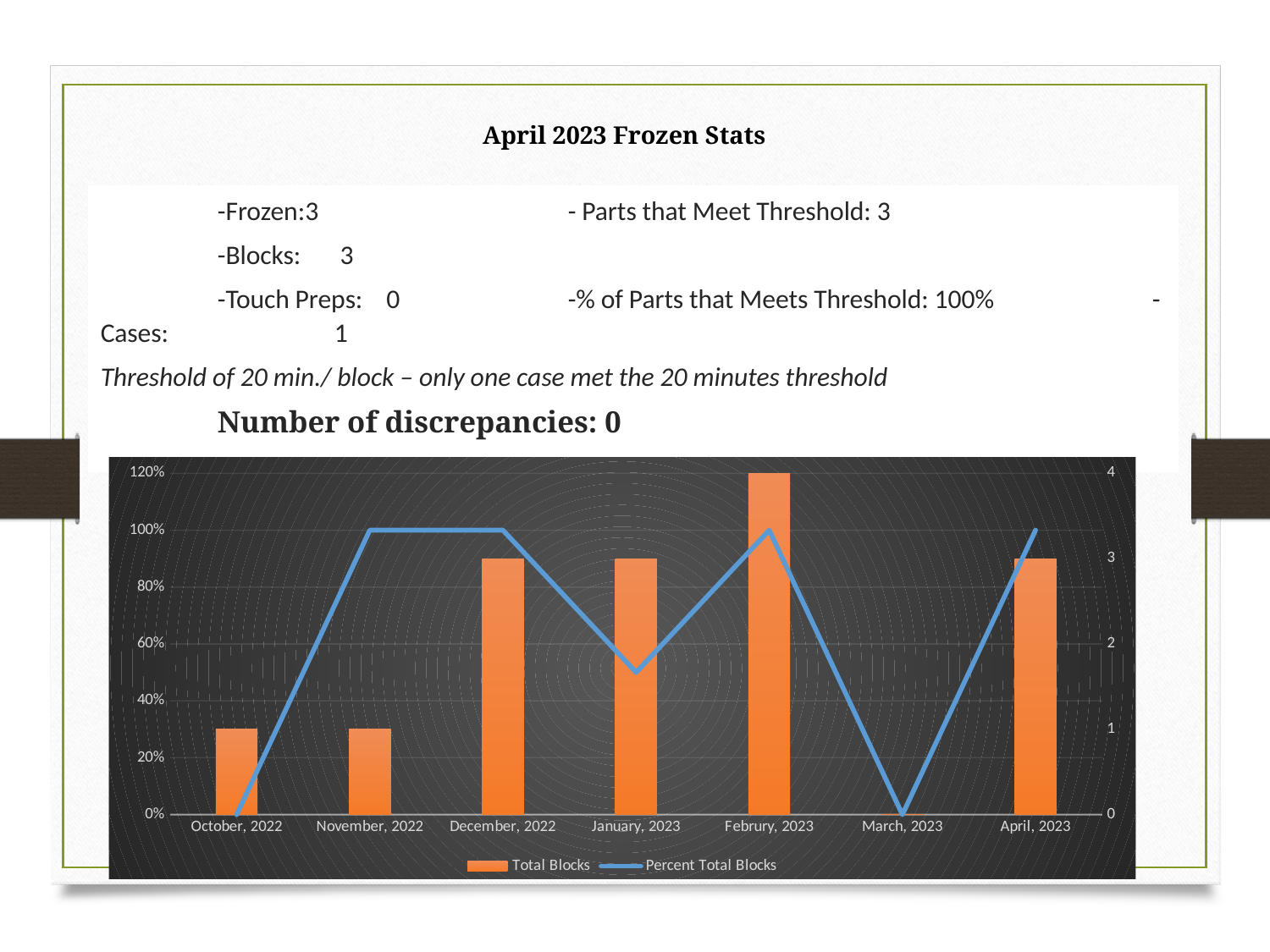
How many months are shown along the x axis of the chart? 7 What is the Total Blocks value for October, 2022? 1 Which month has the lowest Total Blocks bar? March, 2023 Is the Percent Total Blocks value for January, 2023 greater or less than 60%? less Which month has the highest Total Blocks bar? Februry, 2023 Which has a larger Total Blocks bar, December, 2022 or November, 2022? December, 2022 How many series does the chart legend list? 2 What is the Percent Total Blocks value for November, 2022? 100% What are the two entries in the chart legend? Total Blocks and Percent Total Blocks What kind of chart is shown on the slide? A combination bar and line chart Does the Percent Total Blocks line rise or fall from Februry, 2023 to March, 2023? Fall